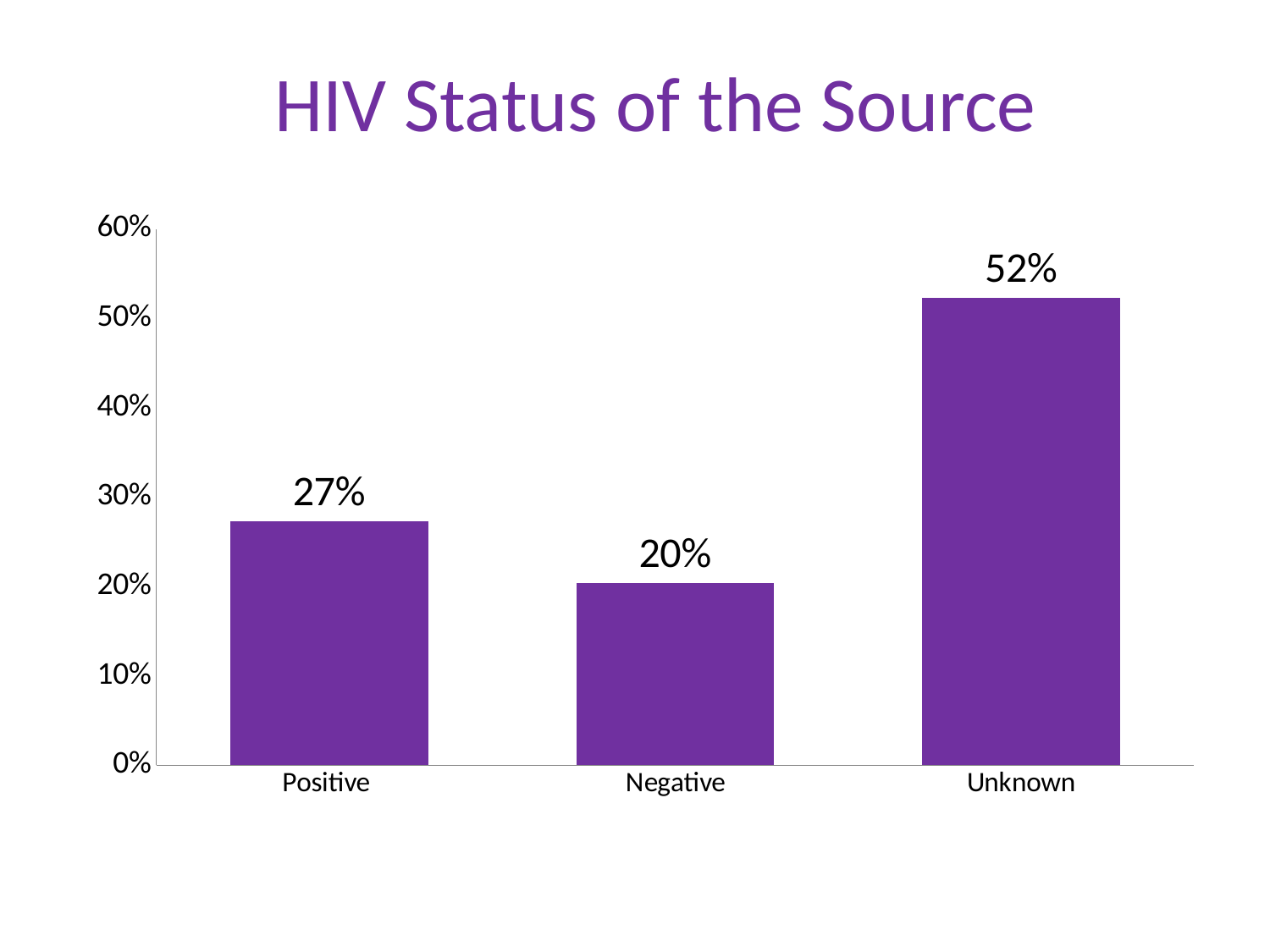
Which is larger, the value for Positive or the value for Negative? Positive Is the value for Unknown greater or less than 50%? greater What is the difference between the values for Positive and Negative? 7% What is the value for Negative? 20% Which category has the highest value? Unknown Which category has the lowest value? Negative What is the difference between the values for Unknown and Positive? 25% How many categories are shown on the x axis? 3 What kind of chart is shown on the slide? bar chart What is the value for Unknown? 52% What is the value for Positive? 27% What is the title of the chart? HIV Status of the Source